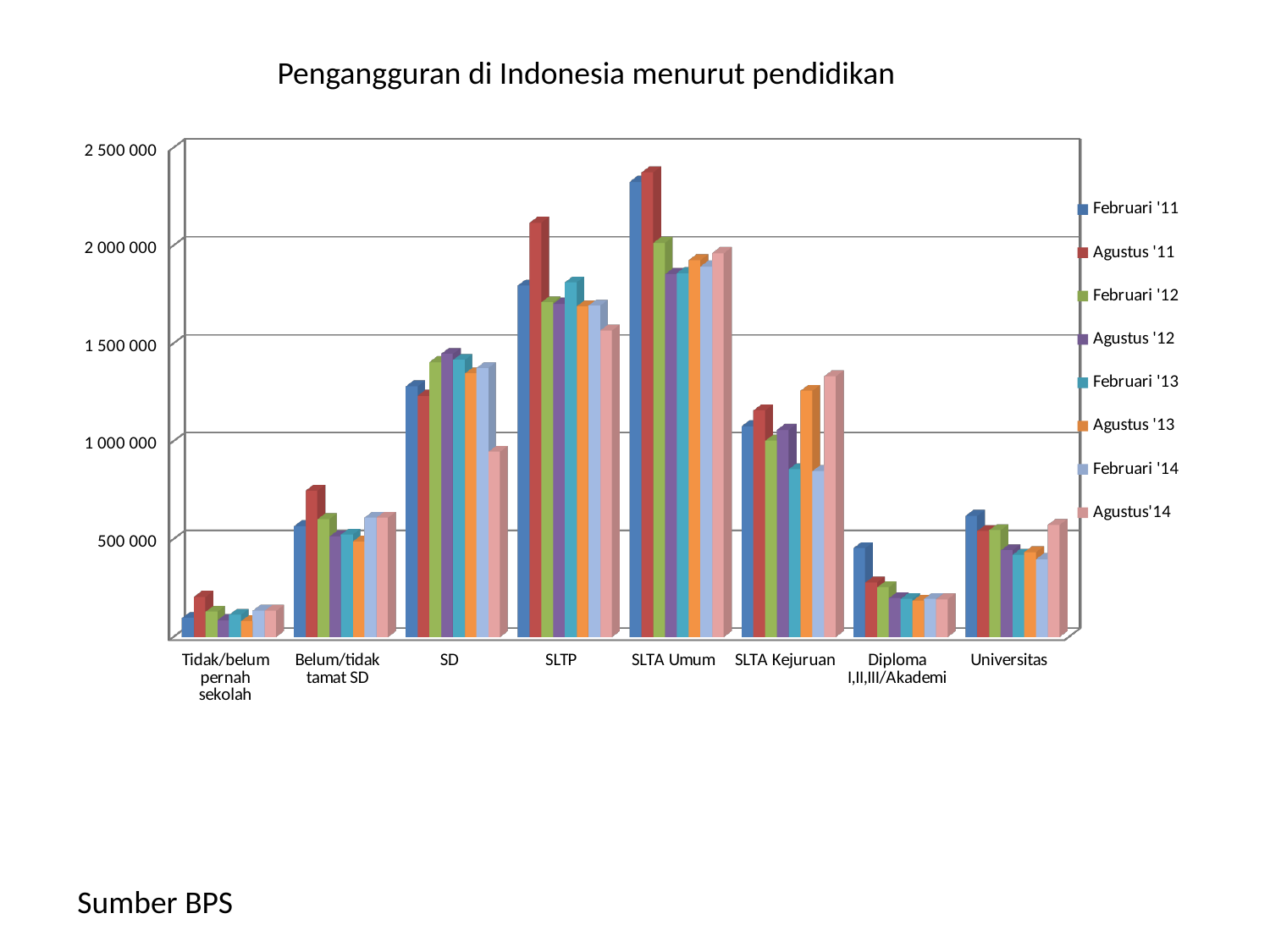
Is the value for Diploma I,II,III/Akademi in Februari '11 greater or less than 500 000? less Is the value for Universitas in Februari '11 greater or less than 500 000? greater For Februari '11, which is larger: SLTA Umum or SLTA Kejuruan? SLTA Umum For SLTP, which is larger: Februari '11 or Agustus '11? Agustus '11 How many education categories are shown on the x axis? 8 Which education category has the highest value for Agustus '11? SLTA Umum What is the title of the chart? Pengangguran di Indonesia menurut pendidikan What kind of chart is shown on the slide? Bar chart Is the value for SLTA Umum in Agustus '11 greater or less than 2 000 000? greater Which education category has the lowest value for Februari '11? Tidak/belum pernah sekolah How many series does the legend list? 8